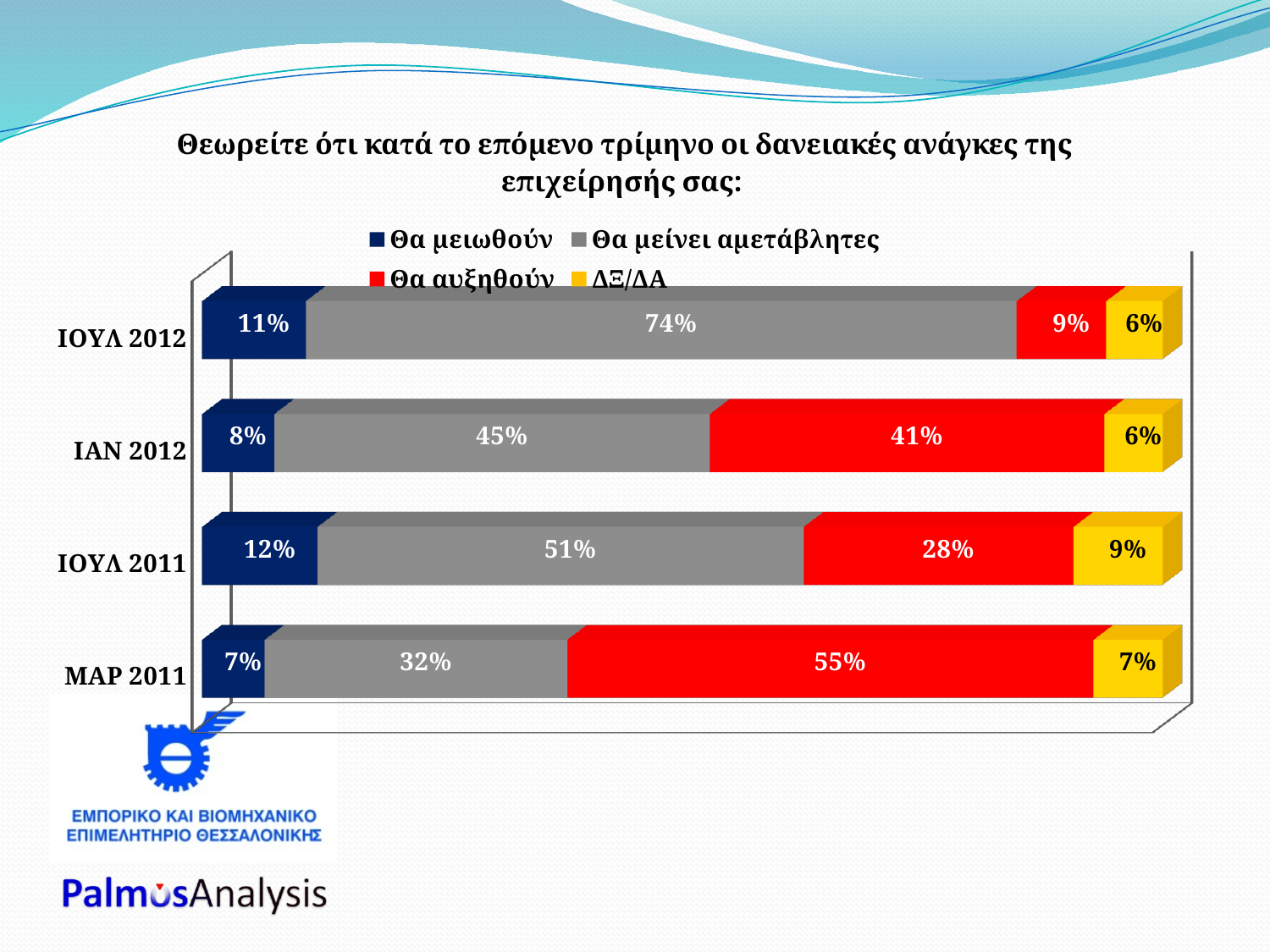
Which is larger: the 'Θα μειωθούν' value for ΙΟΥΛ 2011 or for ΜΑΡ 2011? ΙΟΥΛ 2011 In which period is the 'Θα αυξηθούν' value highest? ΜΑΡ 2011 Which series is shown in red in the legend? Θα αυξηθούν What is the value for 'Θα μείνει αμετάβλητες' in ΙΟΥΛ 2012? 74% What is the value for 'Θα μειωθούν' in ΙΑΝ 2012? 8% How many series does the legend list? 4 What is the value for 'ΔΞ/ΔΑ' in ΙΟΥΛ 2011? 9% What kind of chart is shown on the slide? stacked bar chart What is the difference between the 'Θα αυξηθούν' values for ΙΑΝ 2012 and ΙΟΥΛ 2012? 32% What is the value for 'Θα αυξηθούν' in ΜΑΡ 2011? 55% In which period is the 'Θα μείνει αμετάβλητες' value lowest? ΜΑΡ 2011 How many categories (survey periods) are shown on the chart? 4